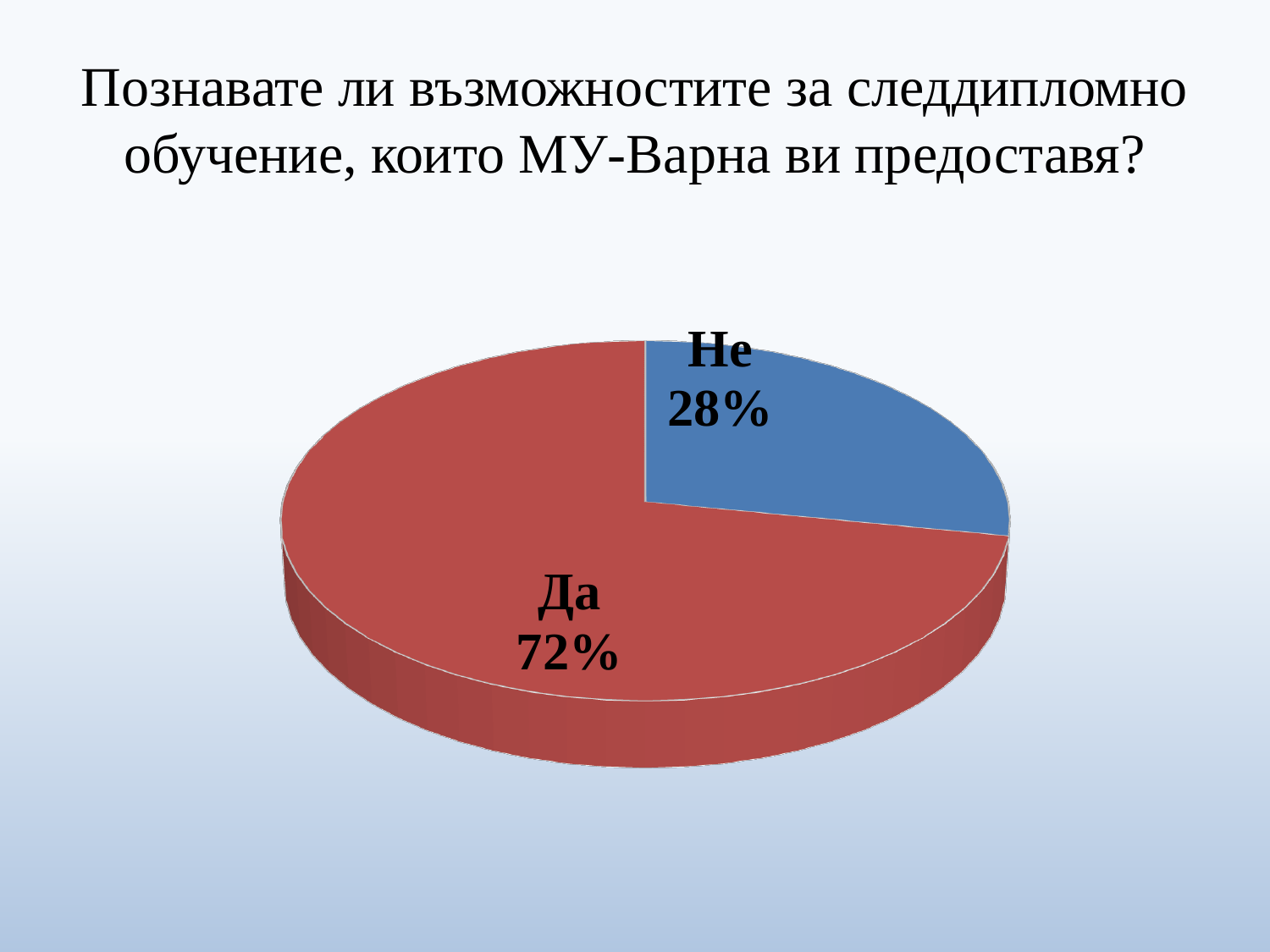
How many slices does the pie chart have? 2 What is the difference in percentage points between the "Да" and "Не" slices? 44 What percentage of respondents answered "Да"? 72% What colour is the "Да" slice? red Which is larger, the "Да" slice or the "Не" slice? Да What kind of chart is shown on the slide? pie chart Which slice is the smallest? Не What share of the pie does the "Не" slice represent? 28% What colour is the "Не" slice? blue Which slice is the largest? Да What percentage of respondents answered "Не"? 28%